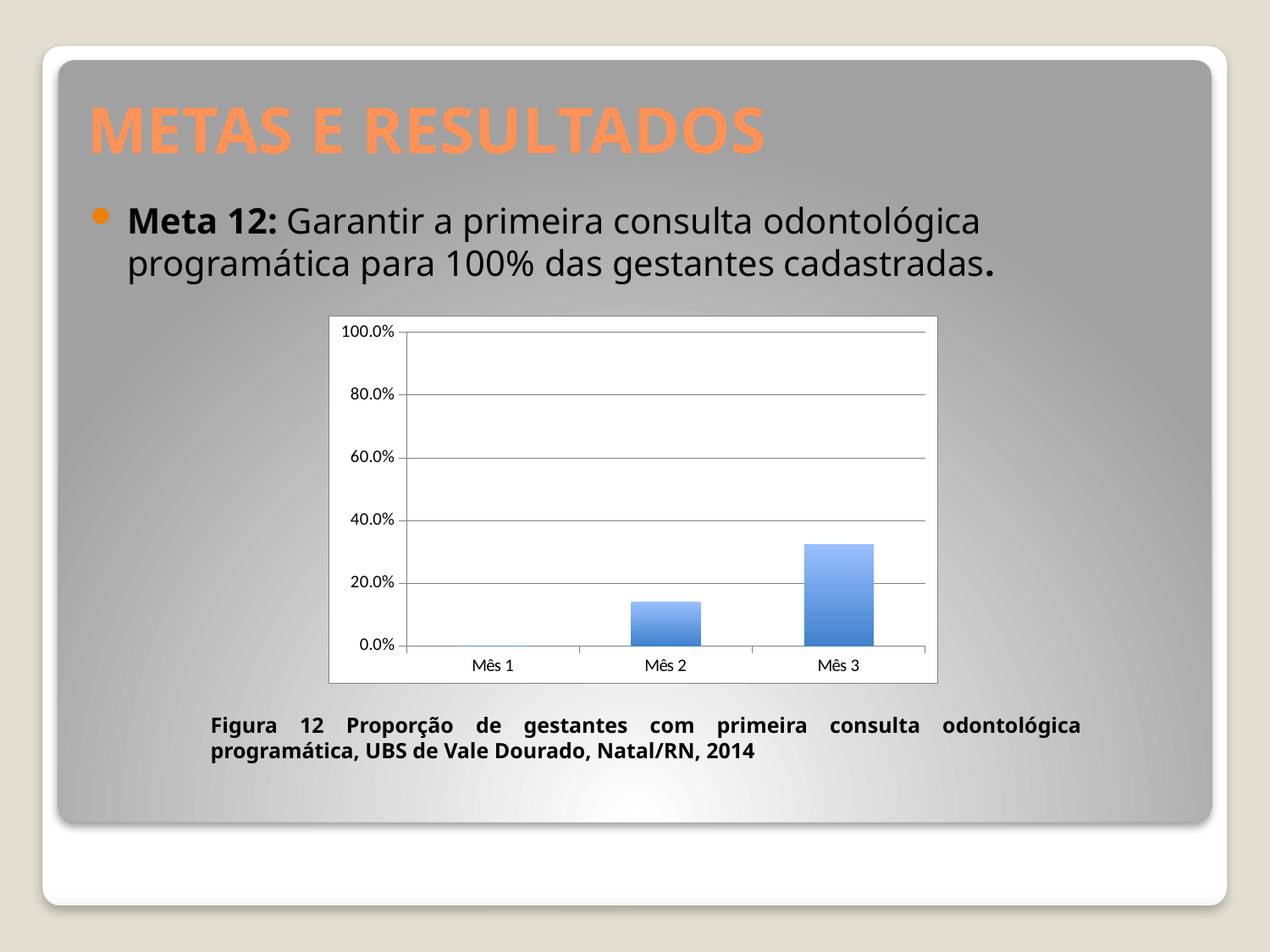
What is the value for Mês 1 in the chart? 0.0% What figure number is given in the caption below the chart? Figura 12 Is the value for Mês 3 greater or less than 20.0%? greater Which month has the lowest value in the chart? Mês 1 Do the values rise or fall from Mês 1 to Mês 3? rise Which month has the highest value in the chart? Mês 3 Which is larger, the value for Mês 2 or the value for Mês 3? Mês 3 Is the value for Mês 2 greater or less than 20.0%? less What is the highest value shown on the chart's vertical axis? 100.0% What kind of chart is shown on the slide? bar chart How many categories are shown on the x axis of the chart? 3 Is the value for Mês 3 greater or less than 40.0%? less